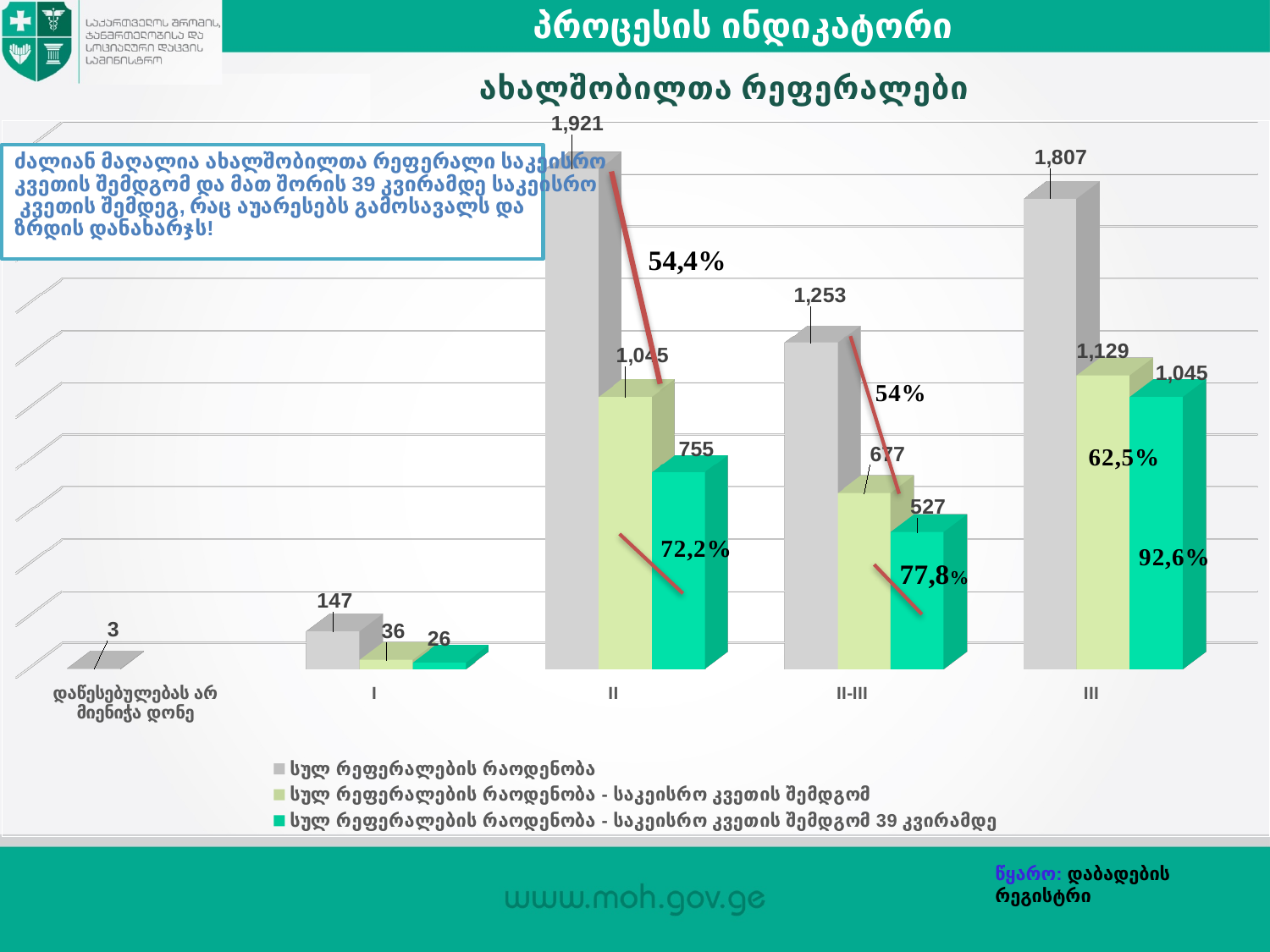
How many series does the legend list? 3 Which is larger: the teal series value for category II or for category III? III What type of chart is shown on the slide? bar chart Which category has the highest value for the gray series (სულ რეფერალების რაოდენობა)? II What is the value of the light green series (საკეისრო კვეთის შემდგომ) for category II-III? 677 How many categories are shown on the x axis? 5 What is the chart's title? ახალშობილთა რეფერალები What is the value of the teal series (საკეისრო კვეთის შემდგომ 39 კვირამდე) for category III? 1,045 What is the difference between the light green and teal series values for category I? 10 What is the value of the gray series (სულ რეფერალების რაოდენობა) for category II? 1,921 Which category has the lowest value for the gray series (სულ რეფერალების რაოდენობა)? დაწესებულებას არ მიენიჭა დონე What is the difference between the gray series values for categories II and III? 114